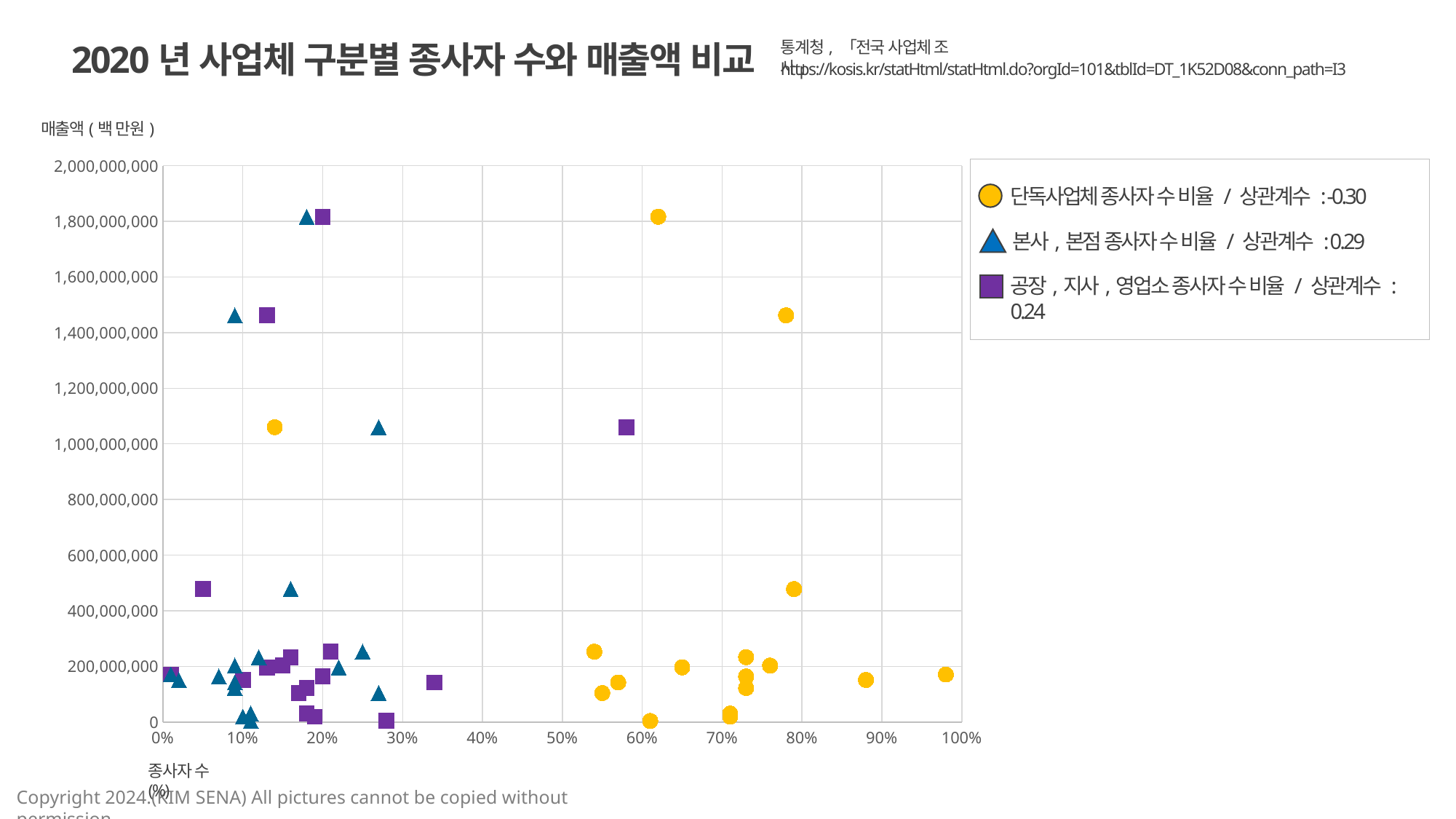
What correlation coefficient (상관계수) does the legend give for 공장, 지사, 영업소 종사자 수 비율? 0.24 Which series has the lowest correlation coefficient shown in the legend? 단독사업체 종사자 수 비율 Which series has the highest correlation coefficient shown in the legend? 본사, 본점 종사자 수 비율 What correlation coefficient (상관계수) does the legend give for 본사, 본점 종사자 수 비율? 0.29 What kind of chart is shown on the slide? scatter chart How many series does the legend list? 3 Which series contains the point with the largest 종사자 수 (%) value on the x axis? 단독사업체 종사자 수 비율 What is the title of the chart? 2020 년 사업체 구분별 종사자 수와 매출액 비교 What is the maximum value shown on the y axis (매출액)? 2,000,000,000 What correlation coefficient (상관계수) does the legend give for 단독사업체 종사자 수 비율? -0.30 Is the 매출액 value of the highest 단독사업체 (yellow circle) point greater or less than 1,600,000,000? greater